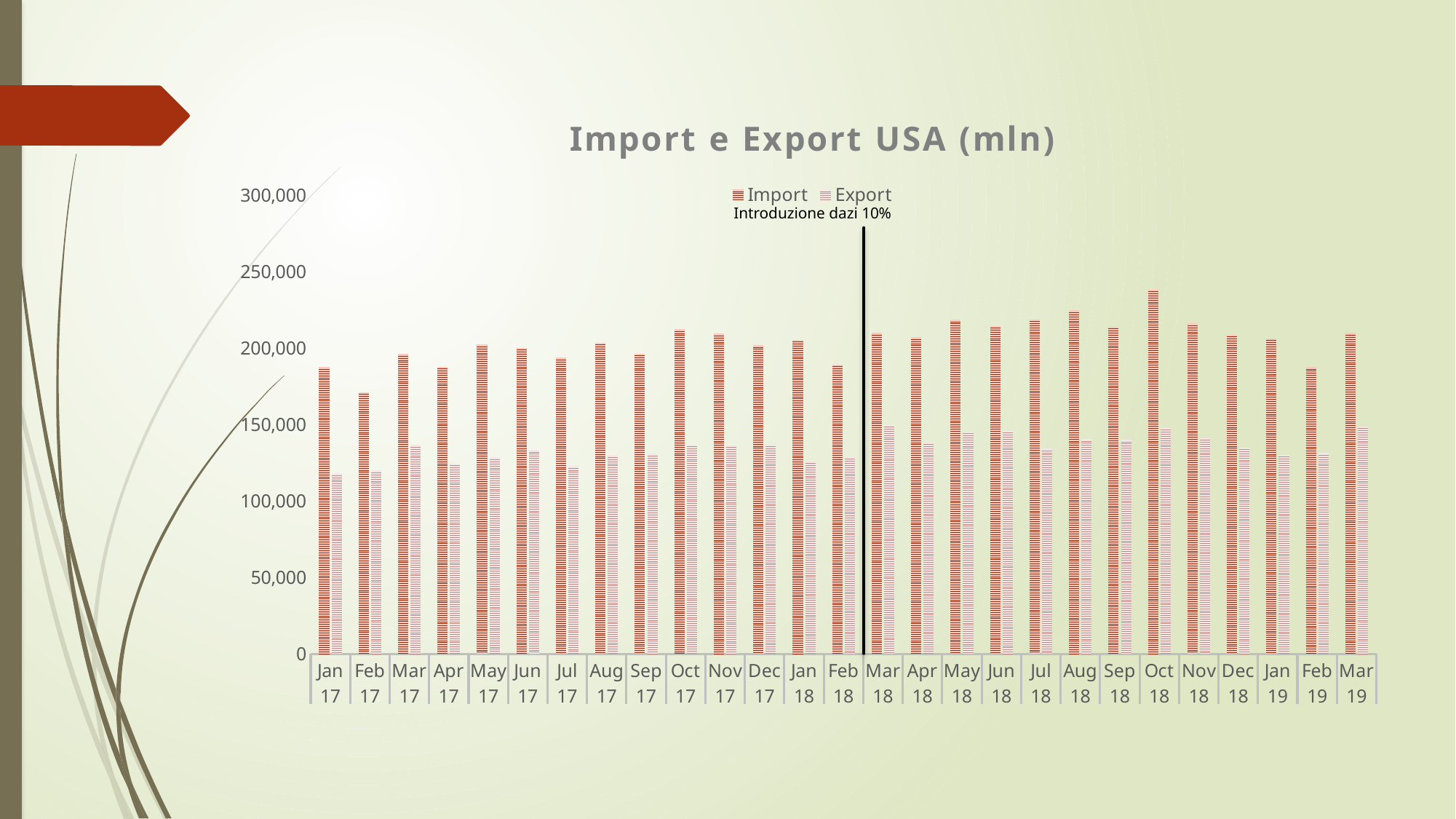
Is the Import value for Feb 17 greater or less than 200,000? less What is the title of the chart? Import e Export USA (mln) How many series does the legend list? 2 What text labels the vertical line drawn on the chart? Introduzione dazi 10% Is the Export value for Apr 17 greater or less than 150,000? less In which month is the Import value highest? Oct 18 How many months are shown on the x axis? 27 Is the Import value for Oct 18 greater or less than 200,000? greater In which month is the Import value lowest? Feb 17 What kind of chart is shown on the slide? bar chart Which is larger, the Export value for Mar 18 or the Export value for Apr 17? Mar 18